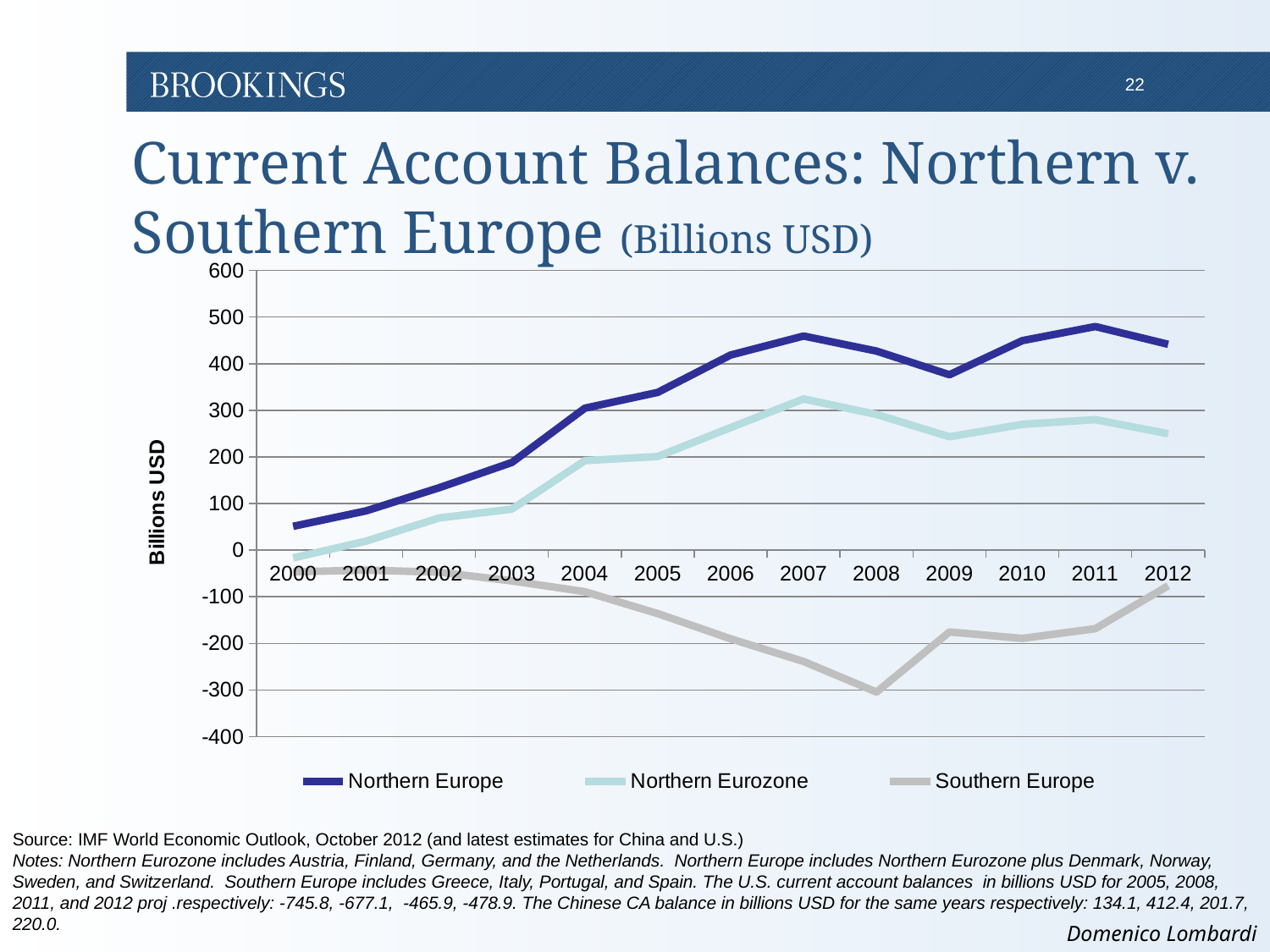
How many series does the legend list? 3 In which year does Southern Europe reach its lowest value? 2008 Is the value for Northern Europe in 2000 greater or less than 100? less In 2008, which is larger: Northern Europe or Northern Eurozone? Northern Europe In which year does Northern Eurozone reach its highest value? 2007 Is the value for Southern Europe in 2008 greater or less than -200? less Is the value for Northern Europe in 2007 greater or less than 400? greater What is the label on the vertical axis? Billions USD Does the Southern Europe line rise or fall from 2000 to 2008? Fall How many years are plotted along the x axis? 13 What kind of chart is shown on the slide? Line chart